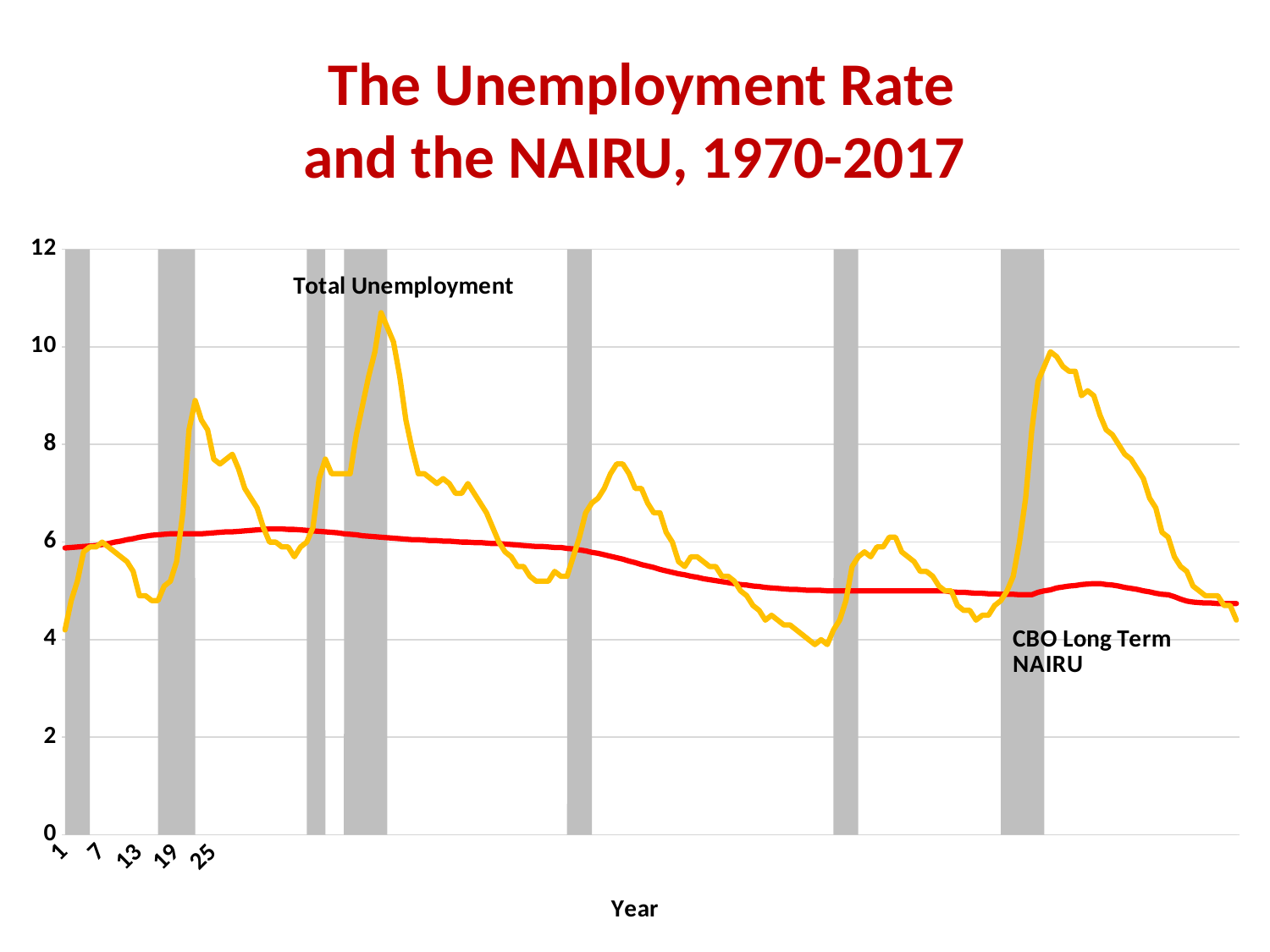
Is the lowest value of the Total Unemployment line greater or less than 6? less What is the title of the chart on the slide? The Unemployment Rate and the NAIRU, 1970-2017 Is the highest value of the Total Unemployment line greater or less than 10? greater Is the CBO Long Term NAIRU value at the far right of the chart greater or less than 6? less What is the label of the horizontal axis? Year Which series is drawn in yellow, Total Unemployment or CBO Long Term NAIRU? Total Unemployment Which series reaches the higher peak value, Total Unemployment or CBO Long Term NAIRU? Total Unemployment What kind of chart is shown on the slide? Line chart Does the CBO Long Term NAIRU line generally rise or fall from the left side of the chart to the right side? Fall